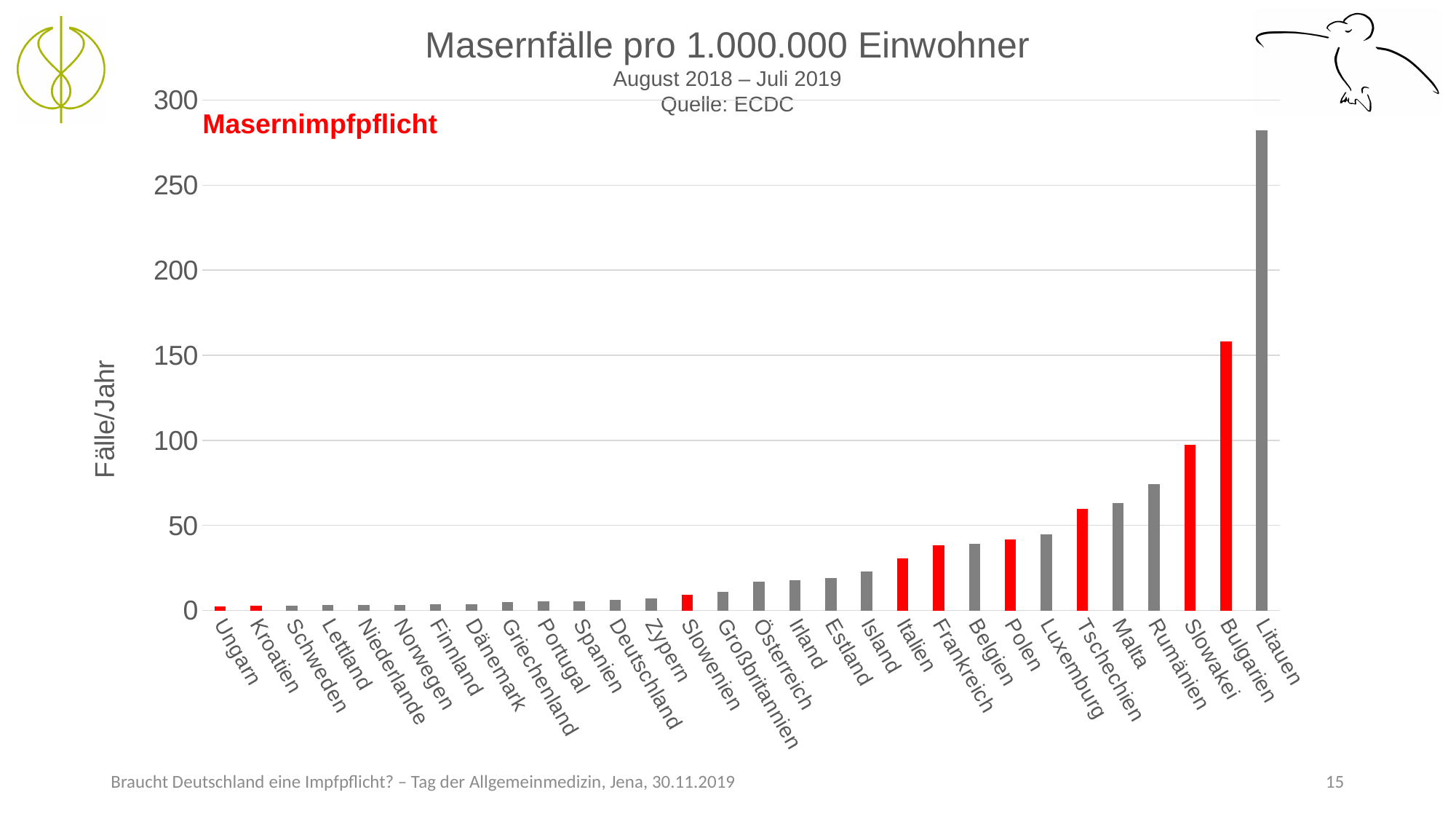
What is the label on the vertical axis of the chart? Fälle/Jahr What is the title of the chart? Masernfälle pro 1.000.000 Einwohner How many countries are shown on the x axis of the chart? 30 Is the value for Slowakei greater or less than 100? less Is the value for Tschechien greater or less than 50? greater Is the value for Deutschland greater or less than 50? less What kind of chart is shown on the slide? bar chart Do the values rise or fall from left to right along the x axis? rise Which country has the highest value in the chart? Litauen Which has the larger value, Rumänien or Malta? Rumänien